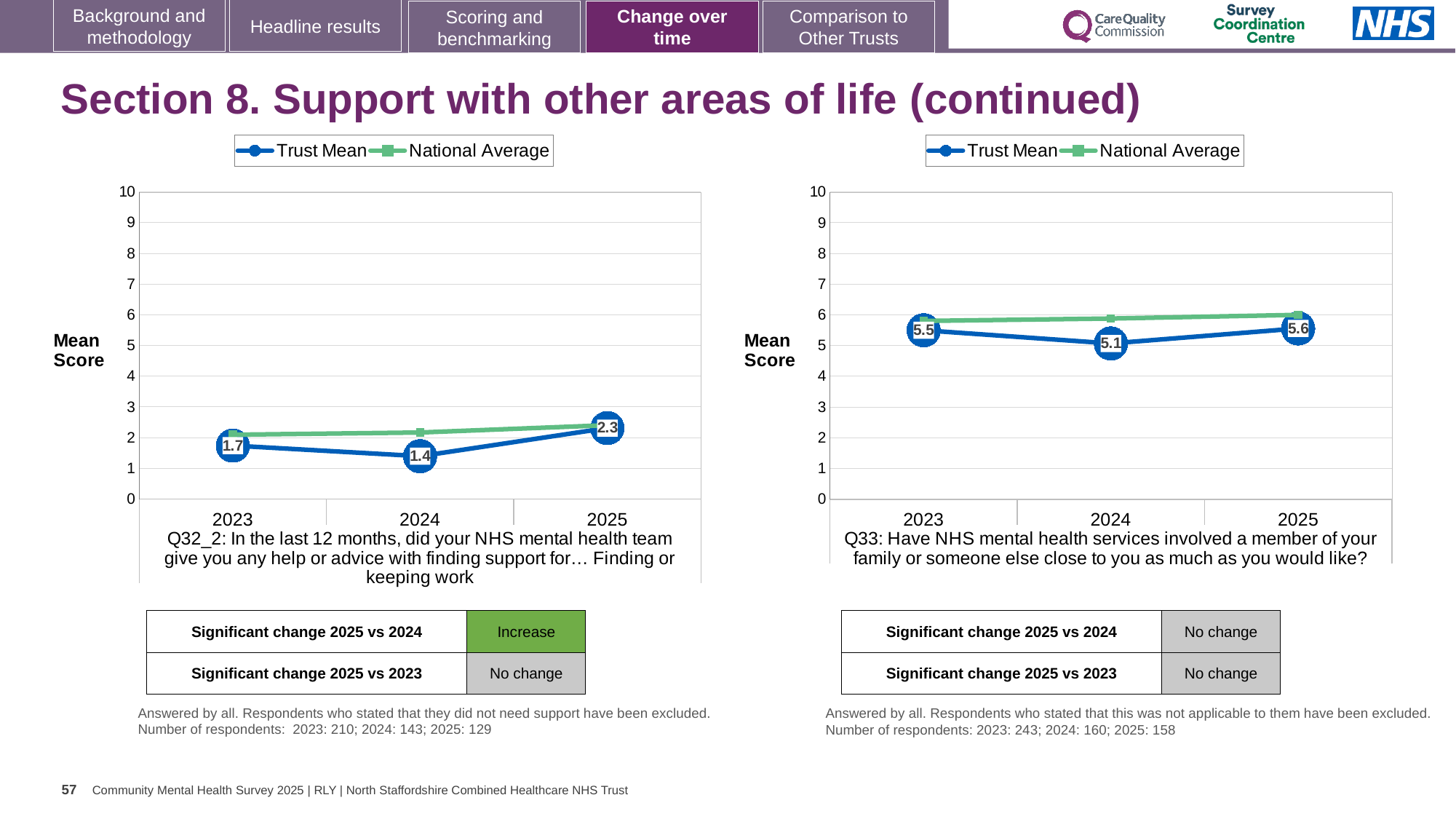
In the left chart (Q32_2), what is the difference between the Trust Mean for 2025 and 2024? 0.9 In the left chart (Q32_2), which year has the highest Trust Mean? 2025 In the right chart (Q33), what is the difference between the Trust Mean for 2025 and 2024? 0.5 In the right chart (Q33), which year has the lowest Trust Mean? 2024 How many series does the legend of the right chart (Q33) list? 2 In the left chart (Q32_2), what is the Trust Mean for 2025? 2.3 In the left chart (Q32_2), is the National Average for 2025 greater or less than 2? greater In the left chart (Q32_2), what is the Trust Mean for 2024? 1.4 What kind of chart is the right chart (Q33)? Line chart How many years are plotted on the x axis of the left chart (Q32_2)? 3 In the right chart (Q33), is the Trust Mean for 2025 greater or less than the Trust Mean for 2023? greater In the right chart (Q33), what is the Trust Mean for 2023? 5.5